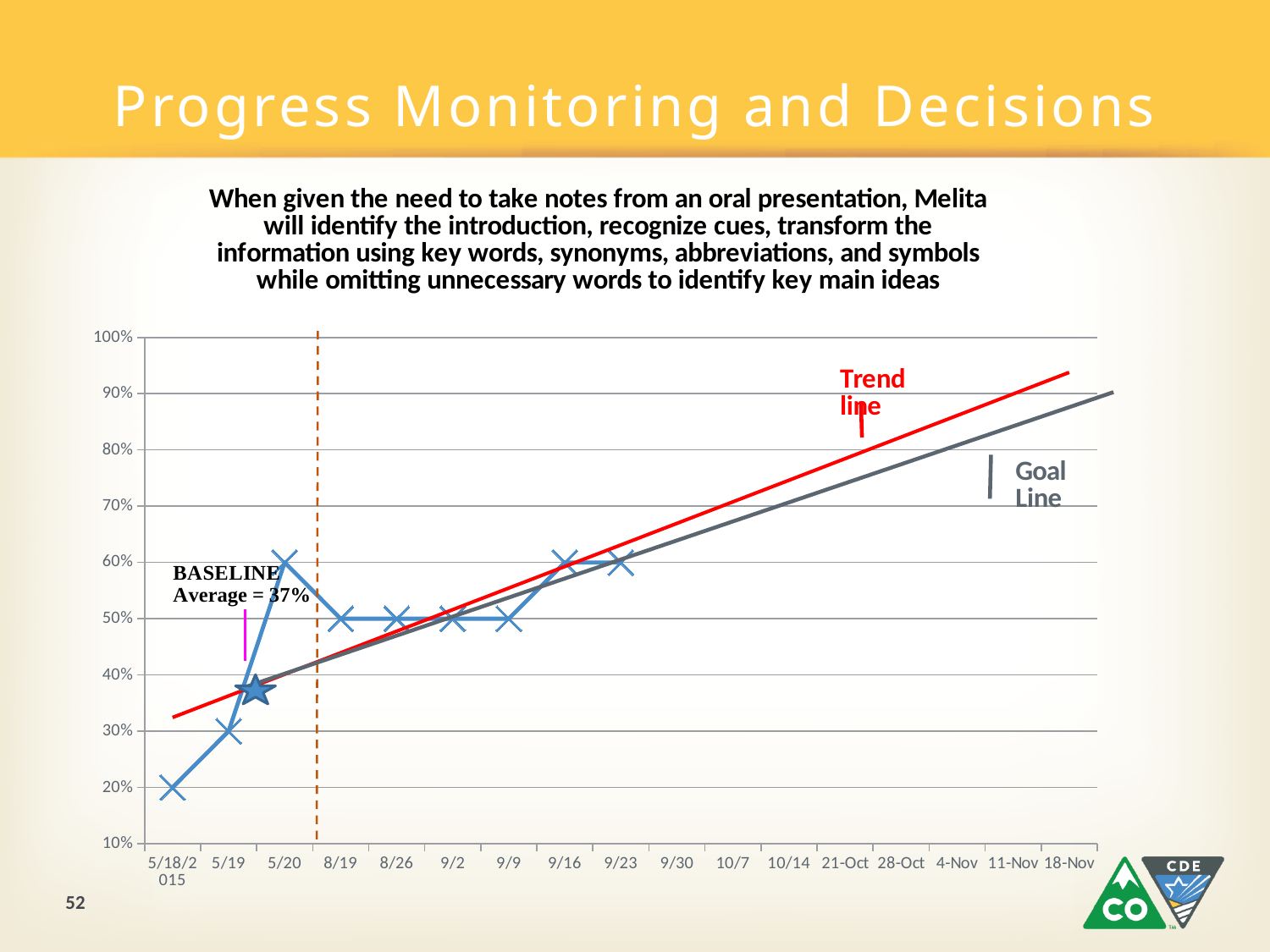
Which date has the lowest plotted value? 5/18/2015 What is the value plotted for 5/18/2015? 20% Is the value for 5/20 greater or less than 50%? greater Do the plotted values rise or fall from 5/18/2015 to 5/20? rise Which is larger, the value for 5/19 or the value for 8/26? 8/26 How many data points are plotted on the blue line? 9 What is the difference between the value for 9/16 and the value for 5/18/2015? 40% What is the value plotted for 9/16? 60% What baseline average is printed on the chart? 37% What kind of chart is shown on the slide? line chart What is the value plotted for 8/19? 50% What is the value plotted for 5/19? 30%